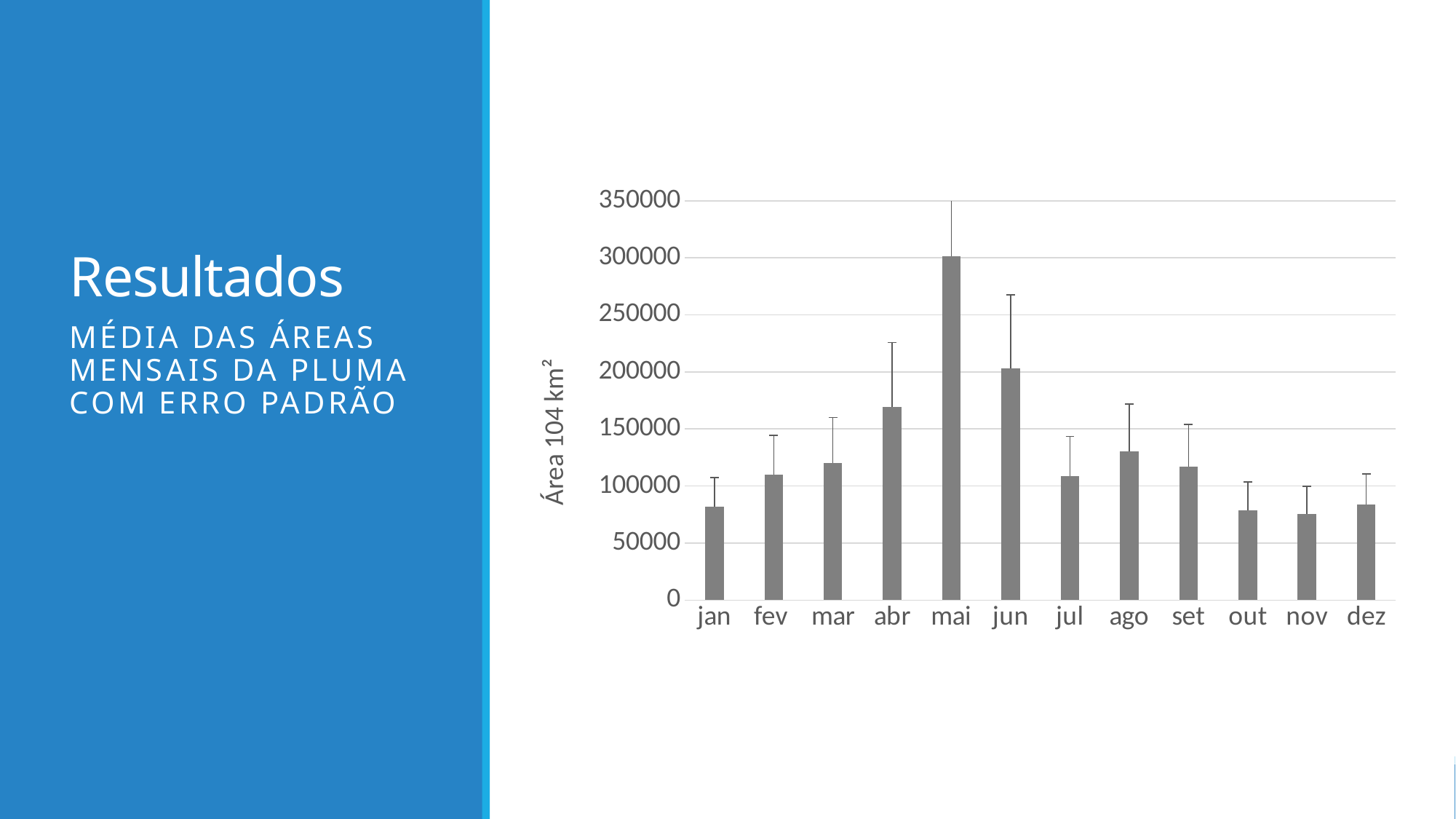
Is the value for out greater or less than 100000? less Which month has the highest bar in the chart? mai Is the value for abr greater or less than 150000? greater Which is larger, the value for abr or the value for ago? abr What is the label on the y axis of the chart? Área 104 km² Do the values rise or fall from jan to mai? rise Is the value for jan greater or less than 100000? less How many months are shown on the x axis of the chart? 12 What kind of chart is shown on the slide? bar chart Which is larger, the value for mai or the value for jun? mai